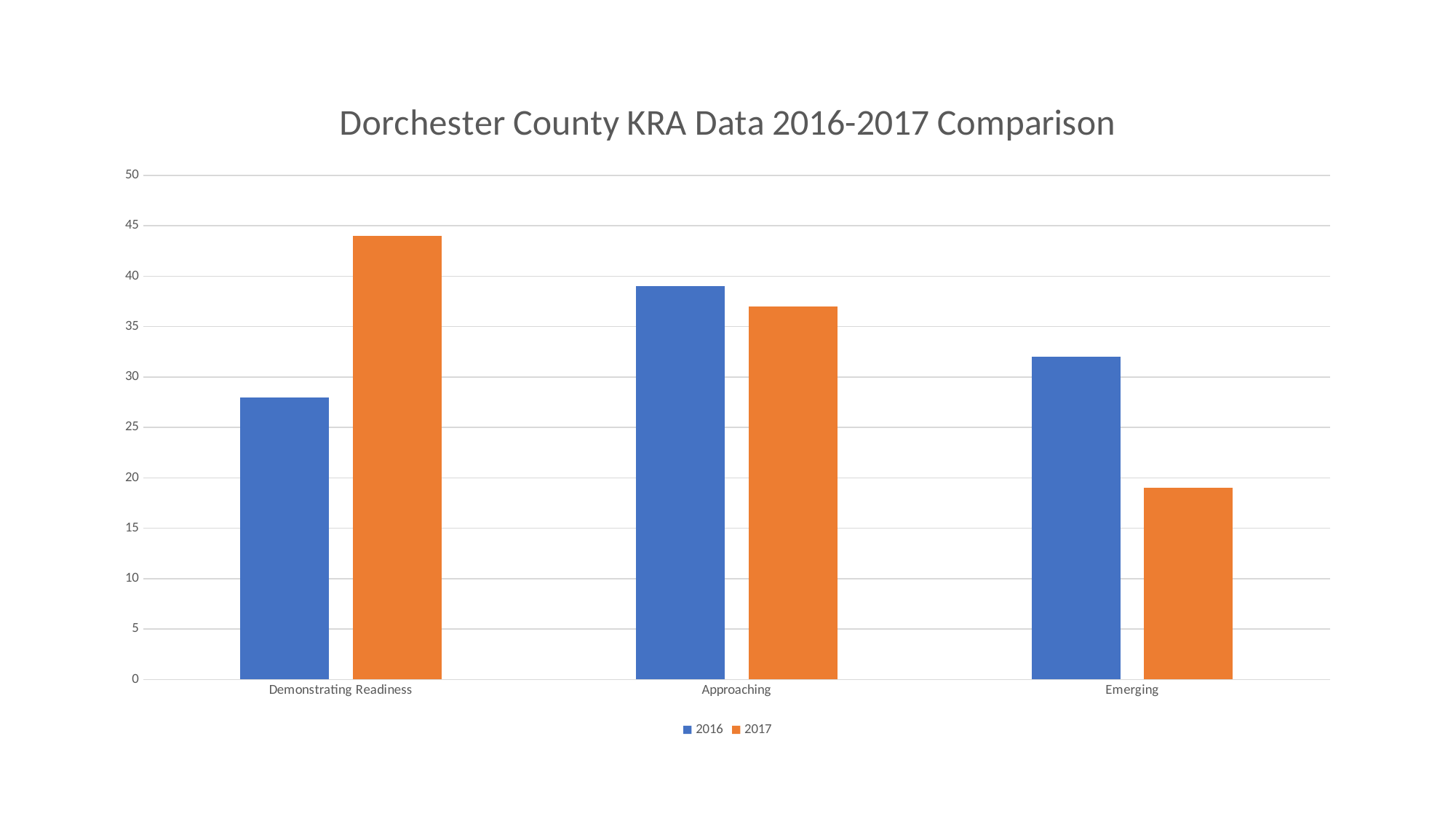
Is the 2016 value for Demonstrating Readiness greater or less than 30? less Which category has the lowest value for the 2016 series? Demonstrating Readiness What kind of chart is shown on the slide? bar chart How many categories are shown on the x axis? 3 How many series does the legend list? 2 Is the 2017 value for Demonstrating Readiness greater or less than 40? greater What is the title of the chart? Dorchester County KRA Data 2016-2017 Comparison For Emerging, which series has the larger value, 2016 or 2017? 2016 Which category has the lowest value for the 2017 series? Emerging For Demonstrating Readiness, which series has the larger value, 2016 or 2017? 2017 Which category has the highest value for the 2017 series? Demonstrating Readiness Which category has the highest value for the 2016 series? Approaching